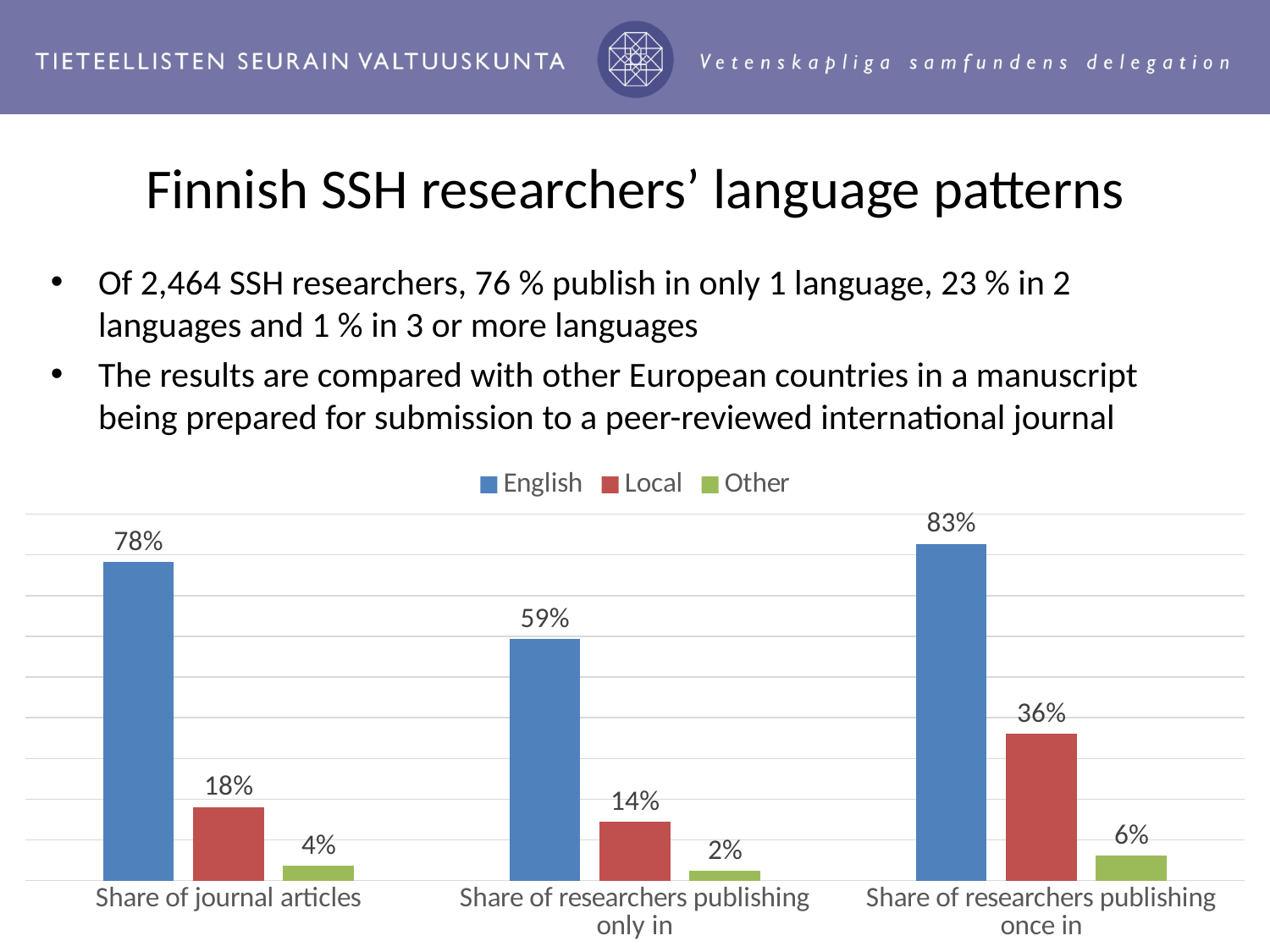
Which series is shown in red in the legend? Local What is the value for Local in the 'Share of researchers publishing once in' category? 36% What kind of chart is shown on the slide? Bar chart What is the difference between the English and Local values in the 'Share of researchers publishing only in' category? 45% What is the value for Other in the 'Share of researchers publishing only in' category? 2% What is the value for English in the 'Share of journal articles' category? 78% In which category is the English series highest? Share of researchers publishing once in In which category is the Other series lowest? Share of researchers publishing only in What is the difference between the English values for 'Share of researchers publishing once in' and 'Share of journal articles'? 5% Which is larger: the Local value for 'Share of journal articles' or the Local value for 'Share of researchers publishing only in'? Share of journal articles How many categories are shown on the x axis? 3 How many series does the legend list? 3